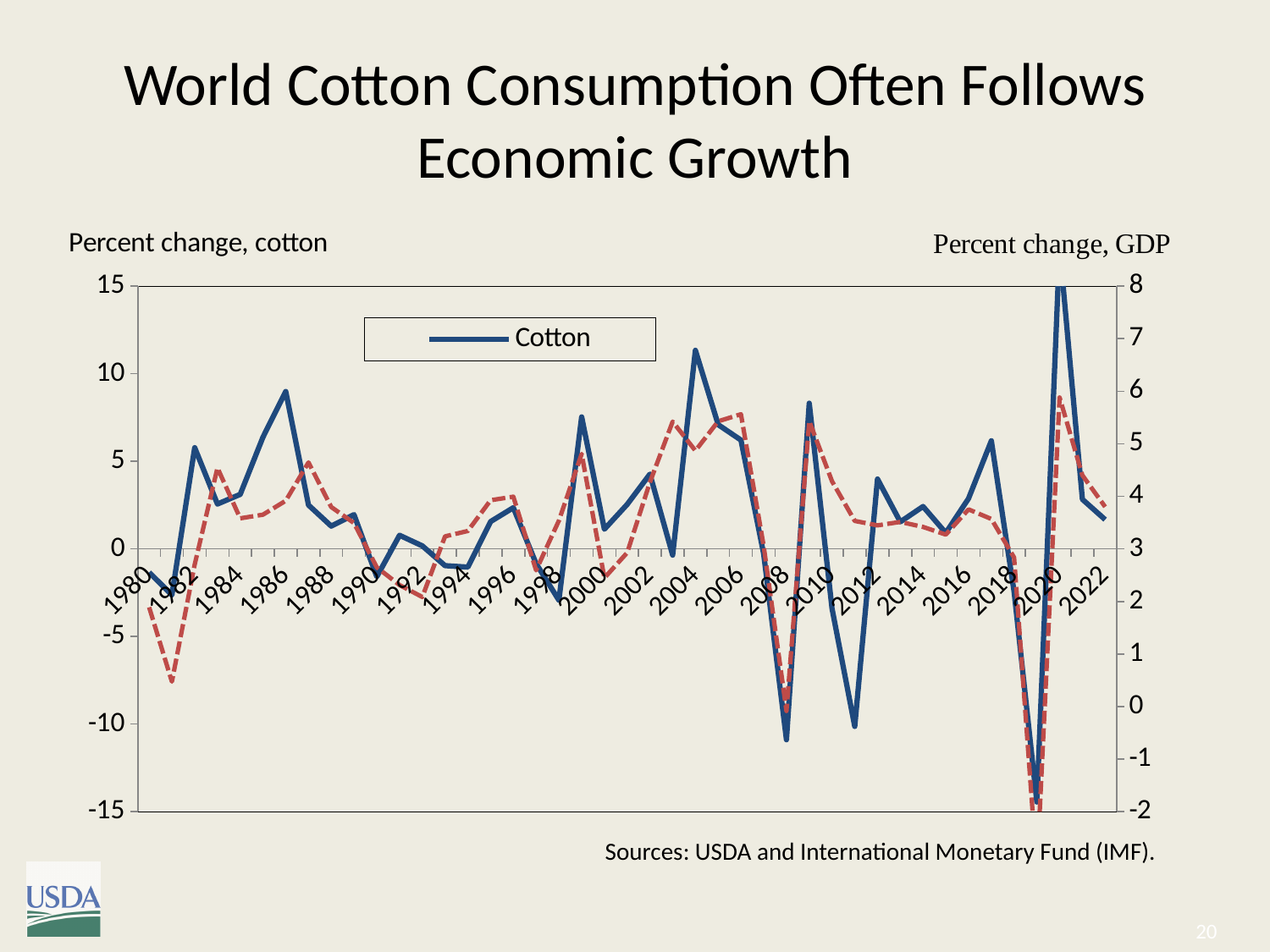
Is the Cotton value for 2004 greater or less than 10? greater In which year does the Cotton line reach its lowest value? 2019 What kind of chart is shown on the slide? line chart Is the Cotton value for 1986 greater or less than 5? greater How many year labels are shown on the x axis? 22 In which year does the Cotton line reach its highest value? 2020 Which year has the higher Cotton value, 2004 or 2009? 2004 Does the Cotton line rise or fall from 2020 to 2022? fall What is the label of the right-hand vertical axis? Percent change, GDP Is the Cotton value for 2008 greater or less than -5? less Which series is named in the legend? Cotton How many series does the legend list? 1